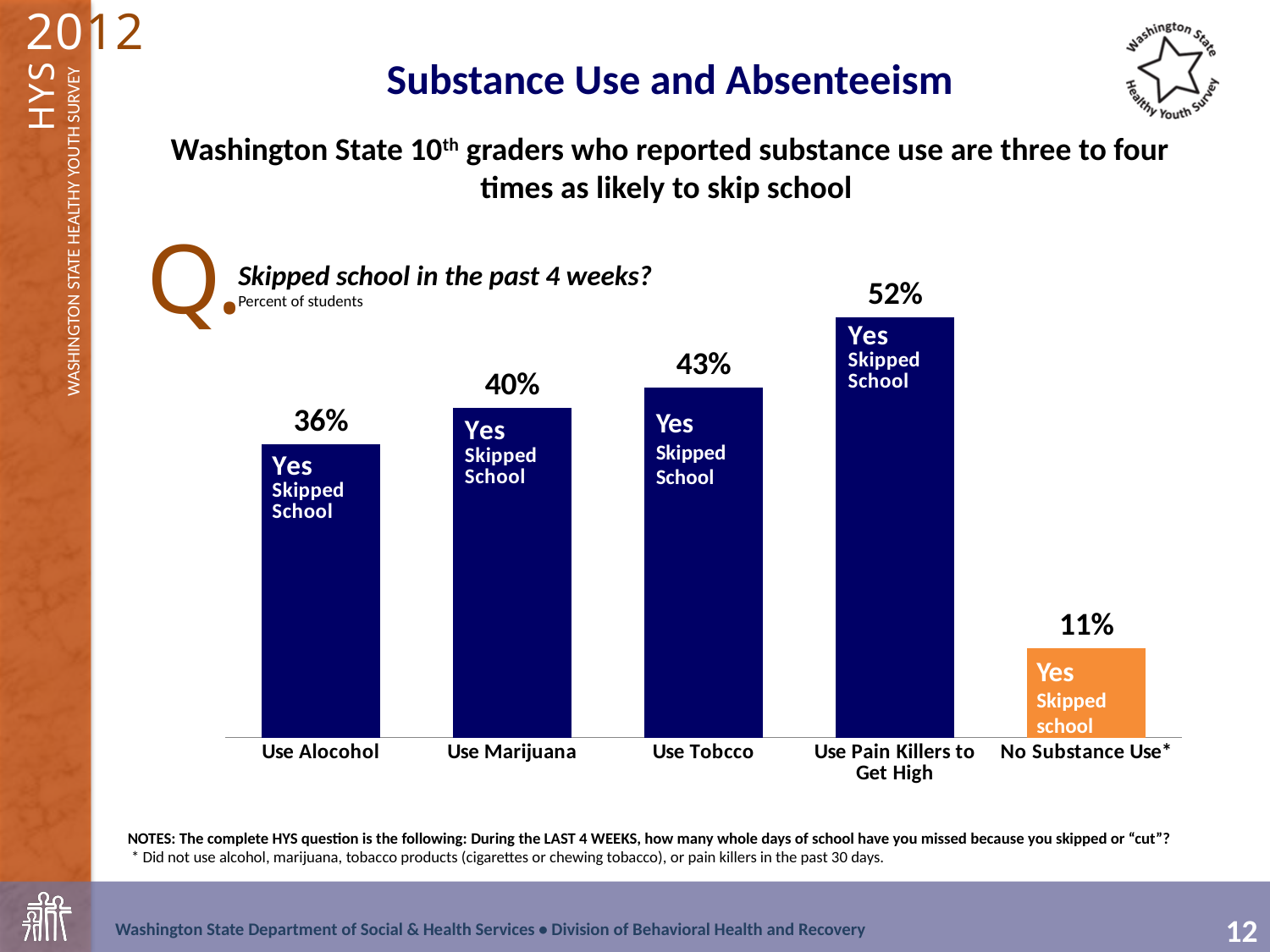
What kind of chart is shown on the slide? Bar chart What is the difference between the Use Tobcco value and the Use Alocohol value? 7% Which is larger, the value for Use Marijuana or the value for Use Tobcco? Use Tobcco What is the difference between the Use Pain Killers to Get High value and the No Substance Use* value? 41% What is the value for the No Substance Use* category? 11% How many categories are shown on the x axis of the chart? 5 Which category has the highest percentage of students who skipped school? Use Pain Killers to Get High Which bar in the chart is coloured orange rather than dark blue? No Substance Use* What percentage is shown for students who use tobacco? 43% What is the value shown for the Use Marijuana category? 40% Which category has the lowest percentage of students who skipped school? No Substance Use* What percentage of students who use alcohol reported skipping school in the past 4 weeks? 36%